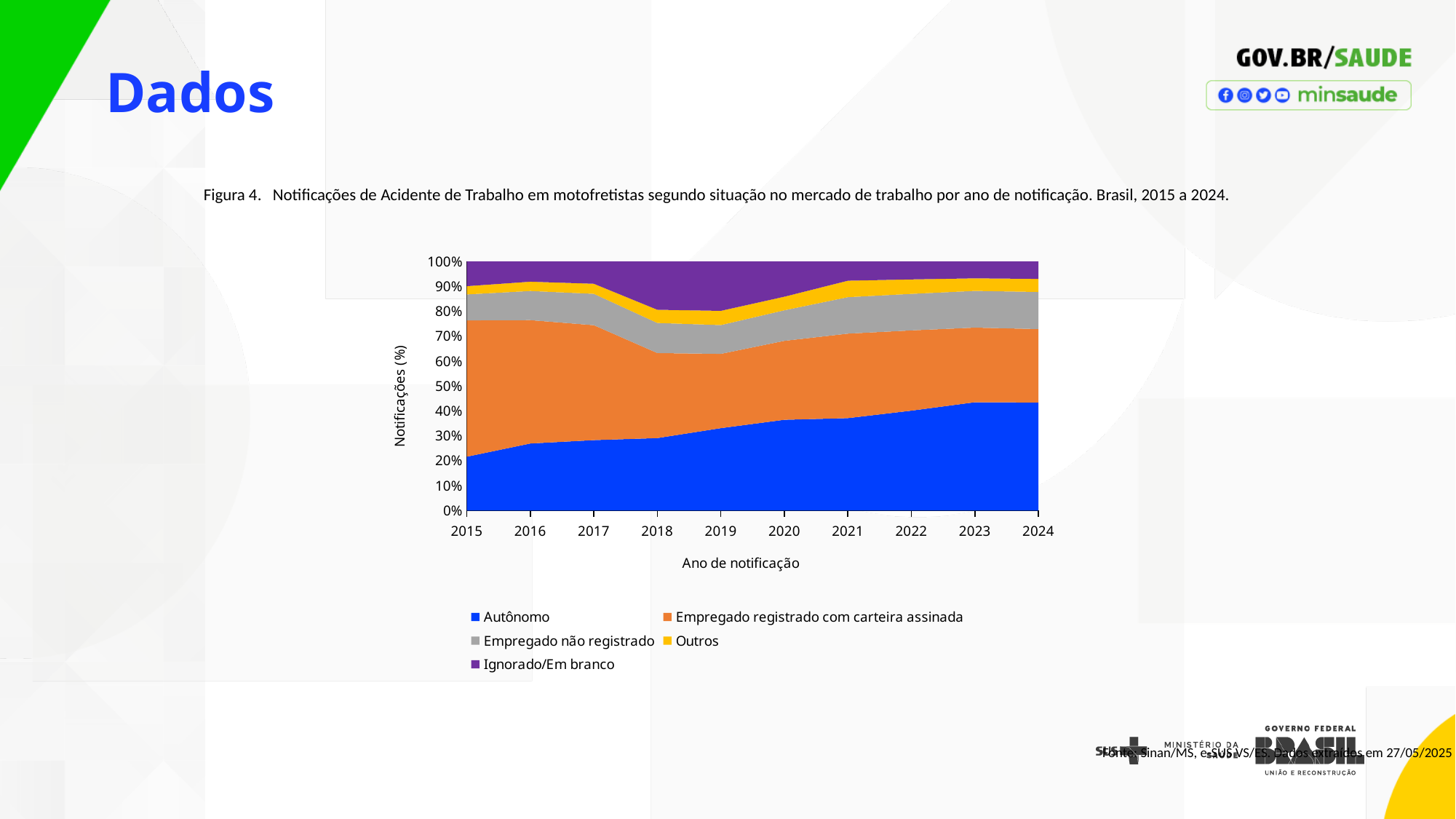
What kind of chart is shown on the slide? Stacked area chart Is the share of Autônomo in 2020 greater or less than 30%? greater Does the share of Autônomo rise or fall from 2015 to 2024? Rises What is the label of the y axis of the chart? Notificações (%) How many years are plotted along the x axis of the chart? 10 Which year has the larger share of Ignorado/Em branco, 2018 or 2024? 2018 Which series is shown in blue in the chart? Autônomo Is the share of Autônomo in 2024 greater or less than 40%? greater Is the share of Autônomo in 2015 greater or less than 30%? less How many series does the chart's legend list? 5 In which year is the share of Autônomo lowest? 2015 Which year has the larger share of Autônomo, 2015 or 2024? 2024